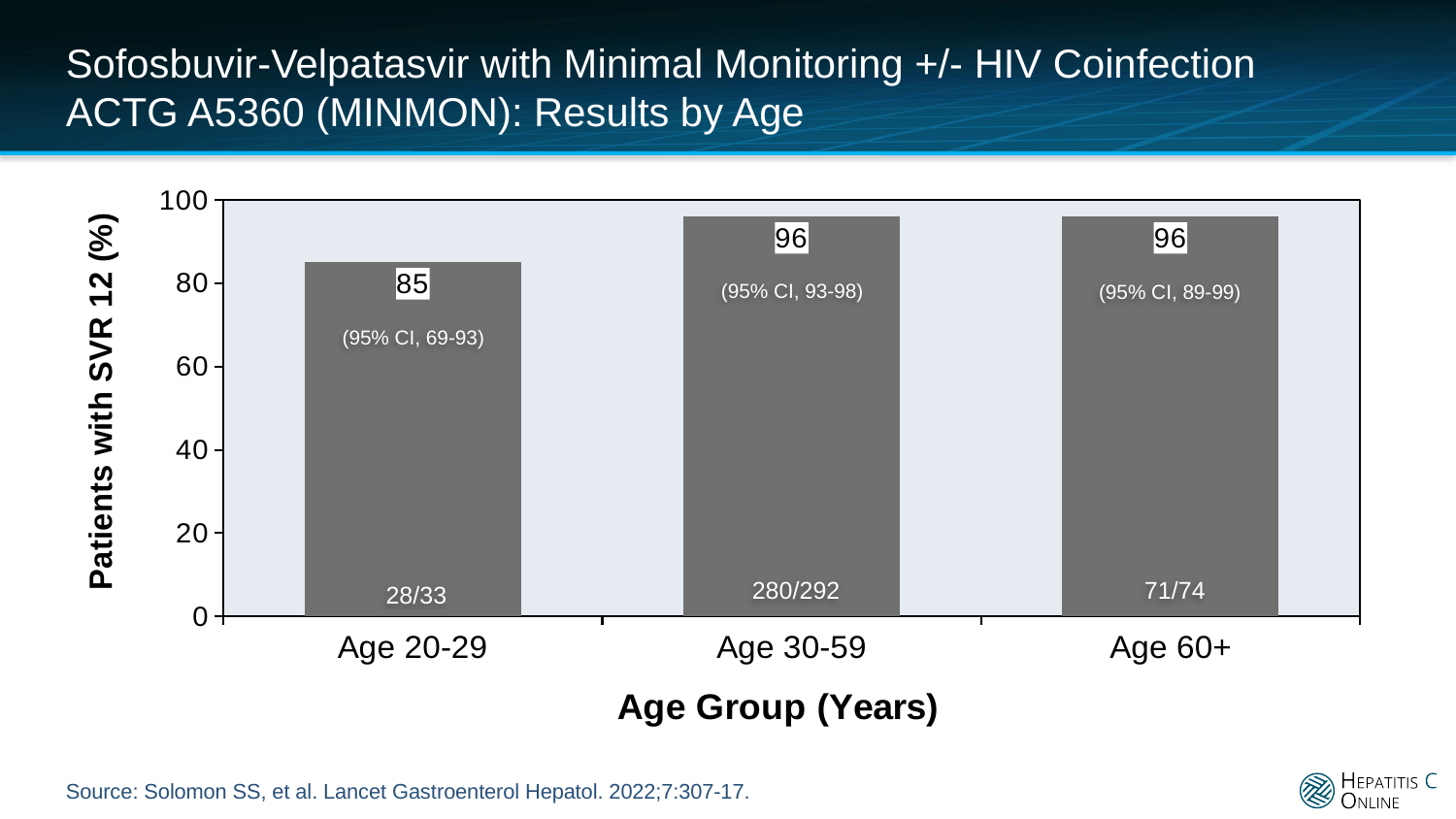
What is the SVR 12 rate for the Age 30-59 group? 96 What is the SVR 12 rate for the Age 20-29 group? 85 What kind of chart is shown on the slide? Bar chart What is the difference in SVR 12 rate between the Age 30-59 group and the Age 20-29 group? 11 What is the 95% confidence interval shown for the Age 60+ group? 89-99 What is the label of the x axis? Age Group (Years) Is the value for Age 20-29 greater or less than 80? greater How many patients achieved SVR 12 out of the total in the Age 30-59 group, as labeled on the bar? 280/292 How many age groups are shown on the chart? 3 What is the SVR 12 rate for the Age 60+ group? 96 Which age group has the lowest SVR 12 rate? Age 20-29 Which has a higher SVR 12 rate, Age 20-29 or Age 60+? Age 60+